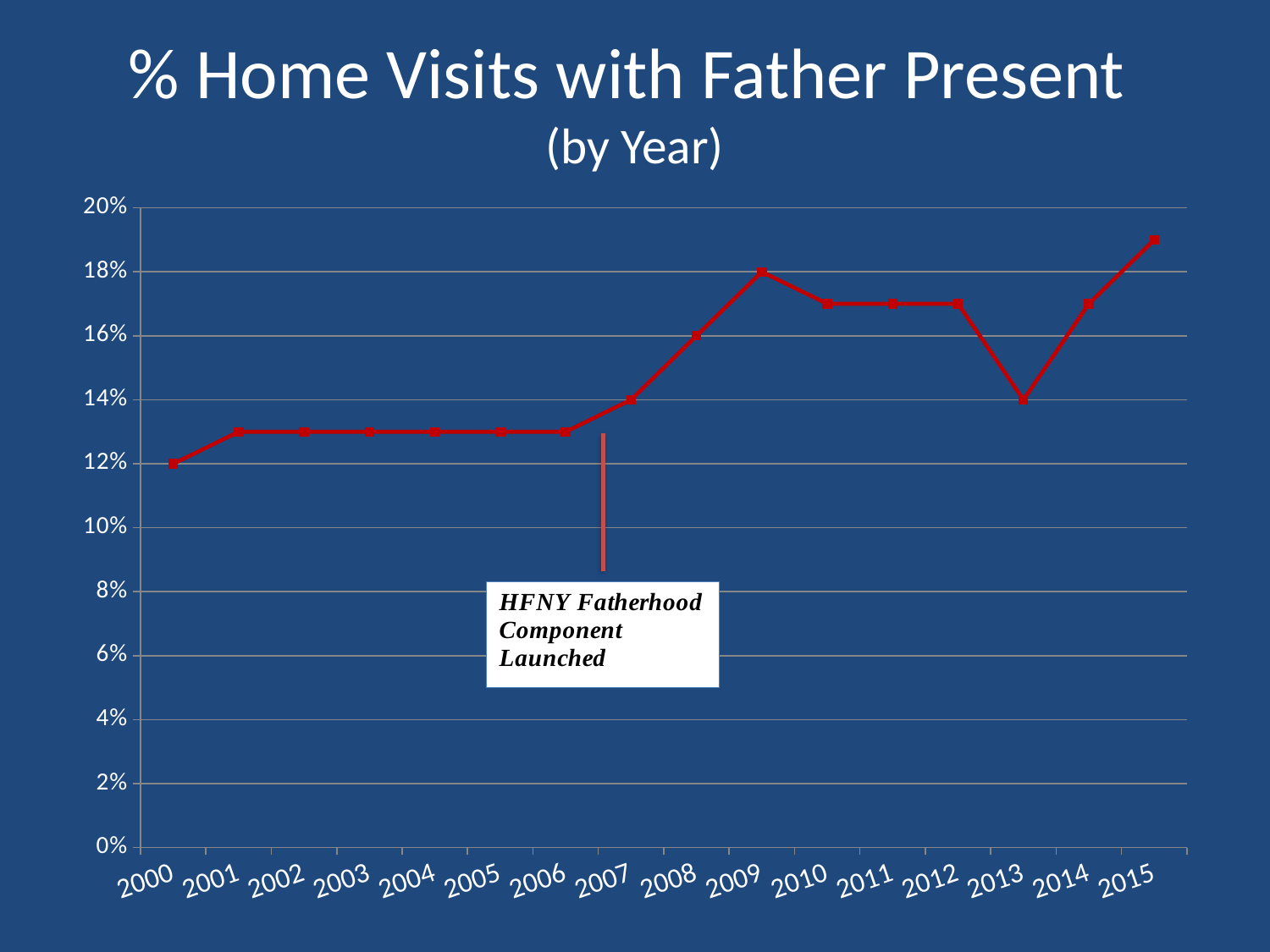
What kind of chart is shown on the slide? line chart Is the value for 2010 greater or less than 18%? less What event does the annotation on the chart mark at 2007? HFNY Fatherhood Component Launched Which is larger, the value for 2009 or the value for 2013? 2009 What is the value for 2013? 14% What is the value for 2009? 18% Which year has the highest value? 2015 What is the difference between the value for 2009 and the value for 2000? 6 percentage points Is the value for 2015 greater or less than 18%? greater How many years (data points) are plotted on the chart? 16 Which year has the lowest value? 2000 What is the value for 2000? 12%